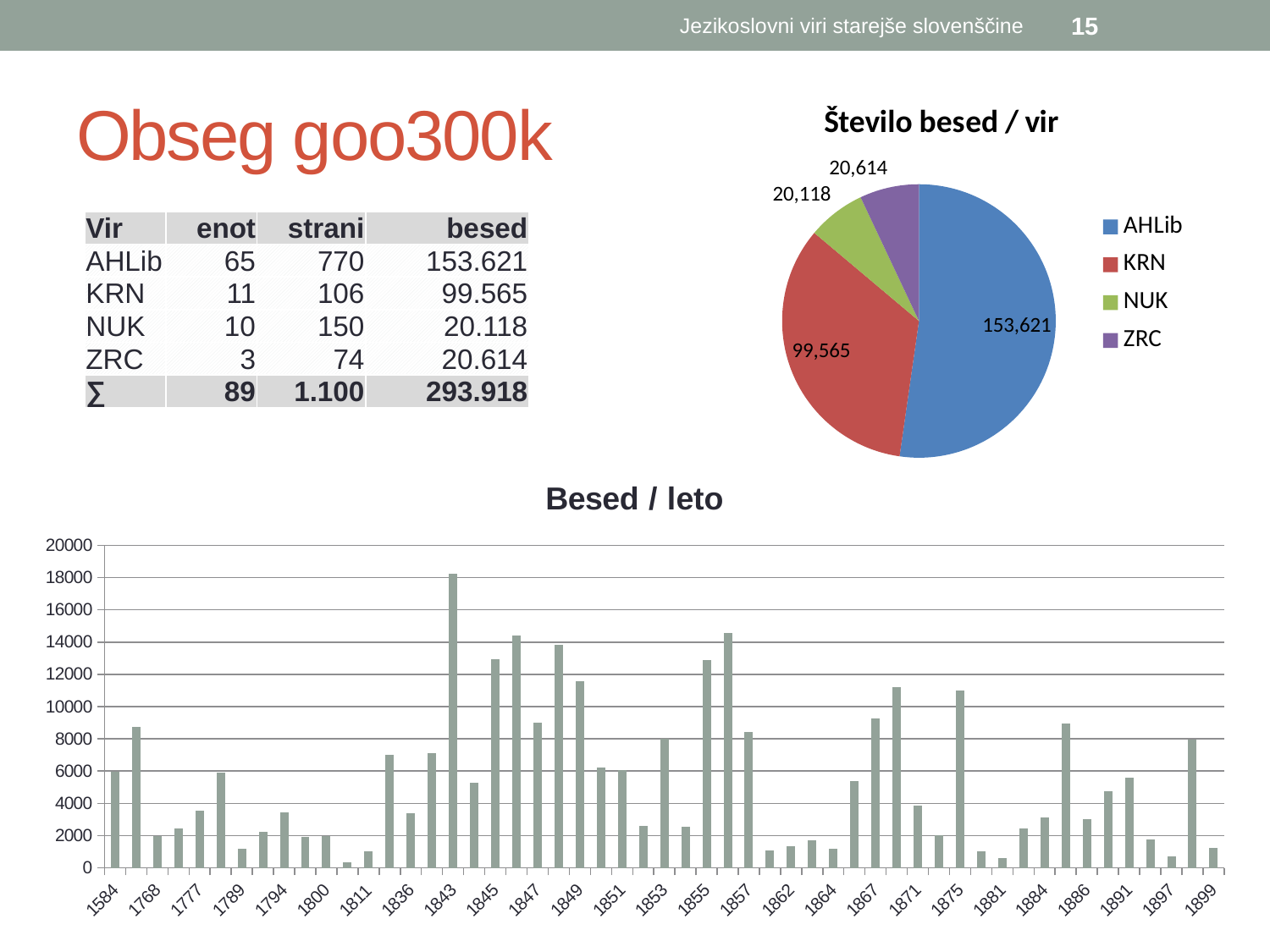
In the bar chart 'Besed / leto', which year has the highest bar? 1843 In the pie chart 'Število besed / vir', which source has the largest slice? AHLib In the pie chart 'Število besed / vir', which is larger, the value for ZRC or the value for NUK? ZRC What kind of chart is 'Besed / leto'? Bar chart In the pie chart 'Število besed / vir', what is the value for KRN? 99,565 In the pie chart 'Število besed / vir', which source has the smallest slice? NUK In the pie chart 'Število besed / vir', what is the difference between the AHLib and KRN values? 54,056 In the bar chart 'Besed / leto', is the value for 1875 greater or less than 10000? greater In the bar chart 'Besed / leto', is the value for 1843 greater or less than 16000? greater In the bar chart 'Besed / leto', is the value for 1811 greater or less than 2000? less How many entries does the legend of the pie chart 'Število besed / vir' list? 4 In the pie chart 'Število besed / vir', what is the value for AHLib? 153,621